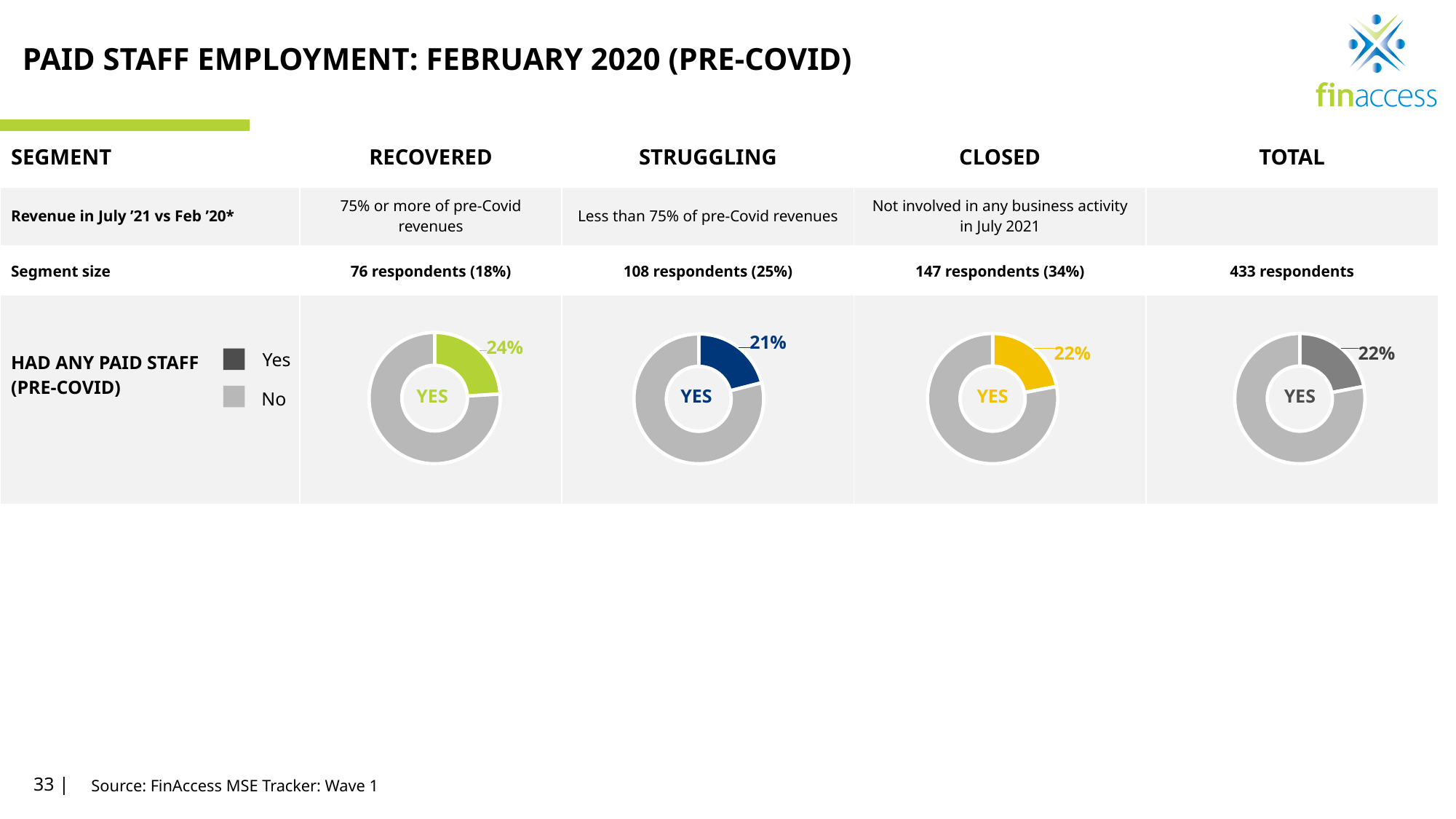
Across the four donut charts, which segment has the lowest share of respondents who had paid staff pre-Covid? STRUGGLING In the CLOSED donut chart, what share of respondents had any paid staff pre-Covid (Yes)? 22% How many categories does the legend for the paid staff charts list? 2 In the STRUGGLING donut chart, what colour is the Yes slice? Dark blue In the TOTAL donut chart, what share of respondents had any paid staff pre-Covid (Yes)? 22% Across the four donut charts, which segment has the highest share of respondents who had paid staff pre-Covid? RECOVERED How many donut charts are shown on the slide? 4 What is the difference in percentage points between the Yes share in the RECOVERED chart and the Yes share in the STRUGGLING chart? 3 percentage points What kind of chart is used to show whether respondents had any paid staff pre-Covid? Donut (pie) chart In the STRUGGLING donut chart, what share of respondents had any paid staff pre-Covid (Yes)? 21% Which is larger: the Yes share in the RECOVERED chart or the Yes share in the CLOSED chart? RECOVERED In the RECOVERED donut chart, what share of respondents had any paid staff pre-Covid (Yes)? 24%